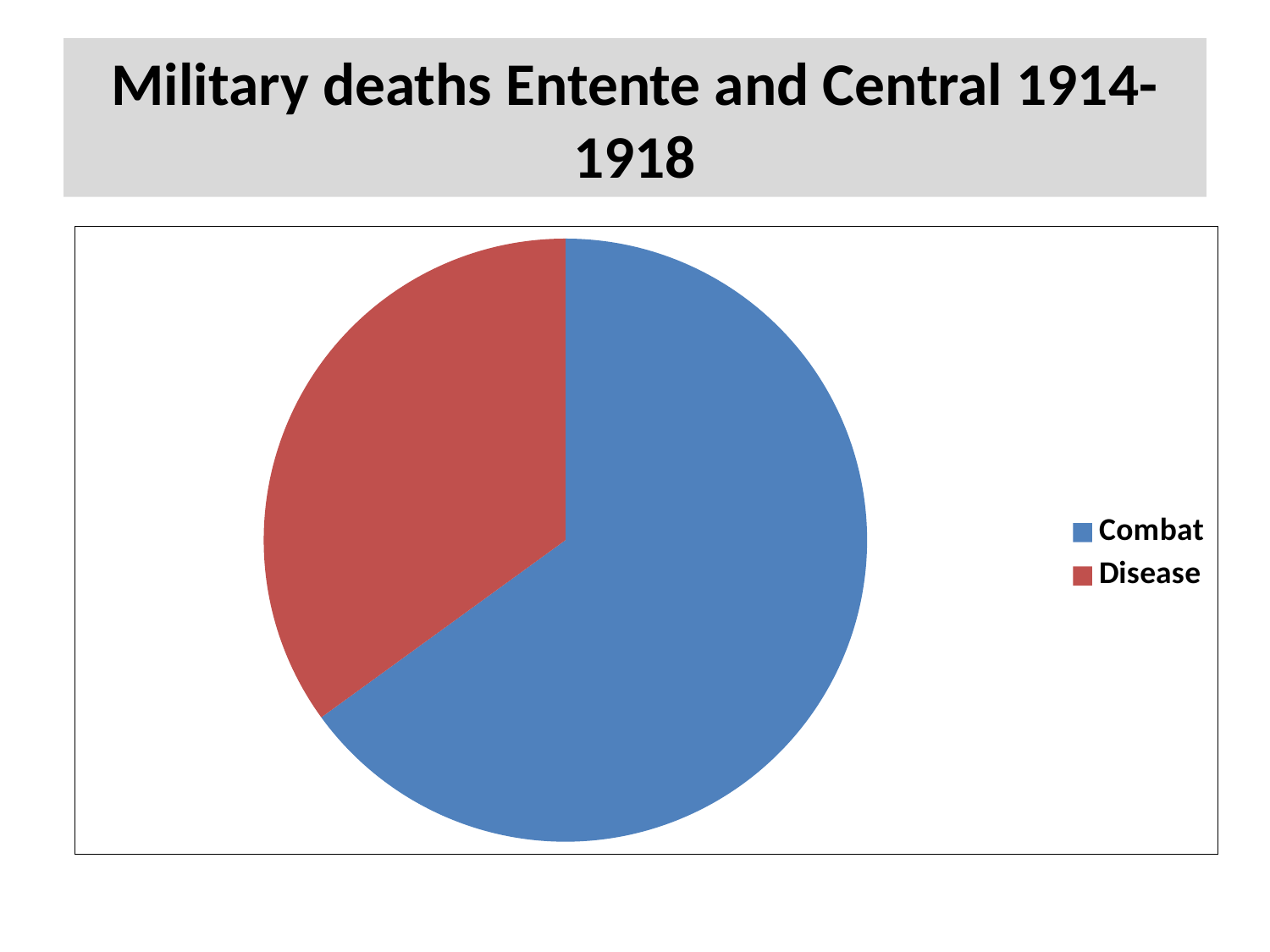
How many entries does the legend list? 2 Which category has the smallest slice of the pie? Disease Which category has the largest slice of the pie? Combat What colour is the Disease slice in the pie chart? red What kind of chart is shown on the slide? pie chart Which slice is larger, Combat or Disease? Combat How many slices does the pie chart have? 2 What is the title of the slide containing the pie chart? Military deaths Entente and Central 1914-1918